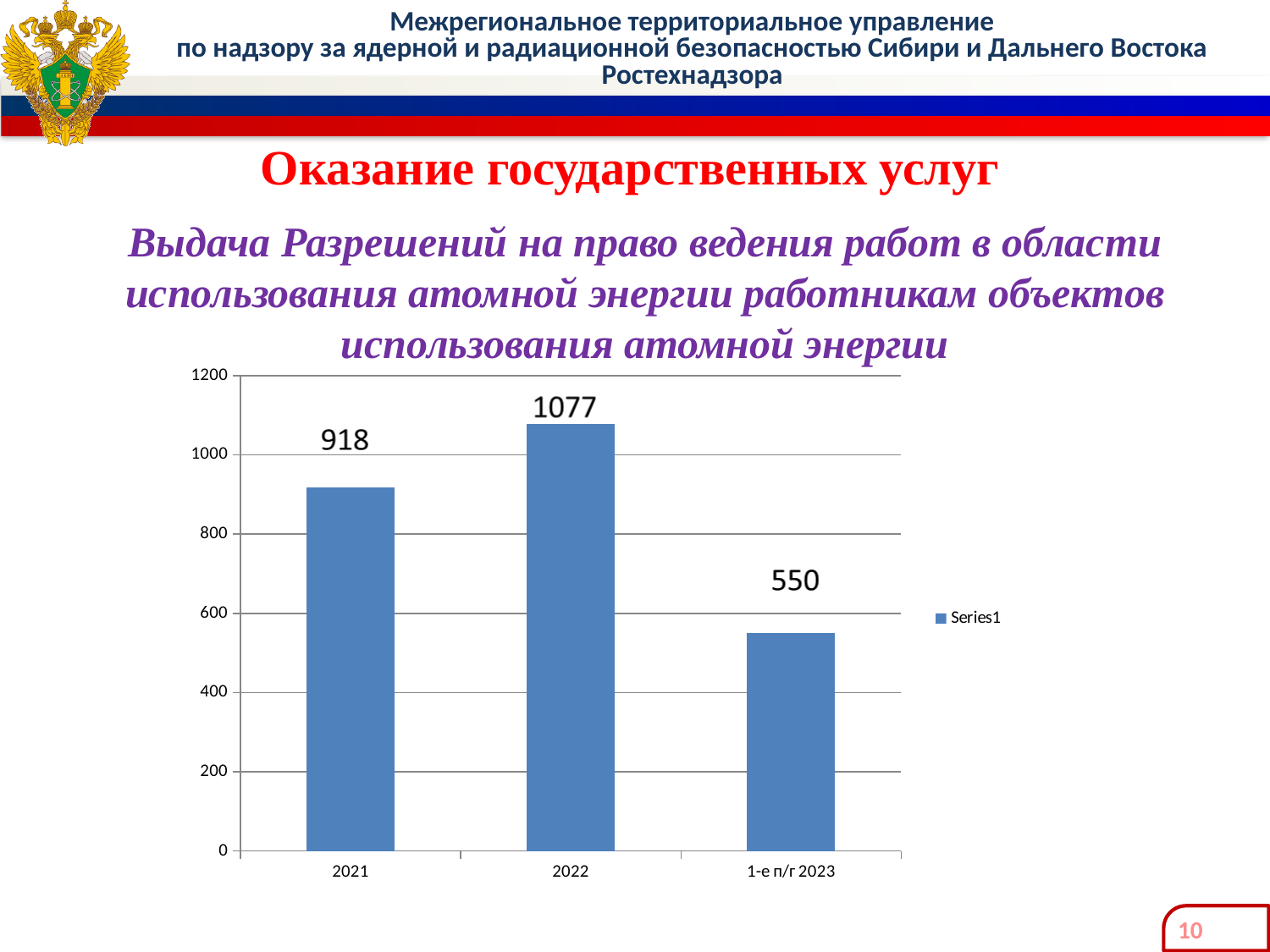
Which category has the highest value? 2022 What is the difference between the values for 2021 and 1-е п/г 2023? 368 What kind of chart is shown on the slide? bar chart How many categories are shown on the x axis? 3 Which is larger, the value for 2021 or the value for 2022? 2022 Is the value for 2022 greater or less than 1000? greater Which category has the lowest value? 1-е п/г 2023 What is the value for 2021? 918 What is the difference between the values for 2022 and 2021? 159 What is the value for 1-е п/г 2023? 550 What series name does the legend list? Series1 What is the value for 2022? 1077